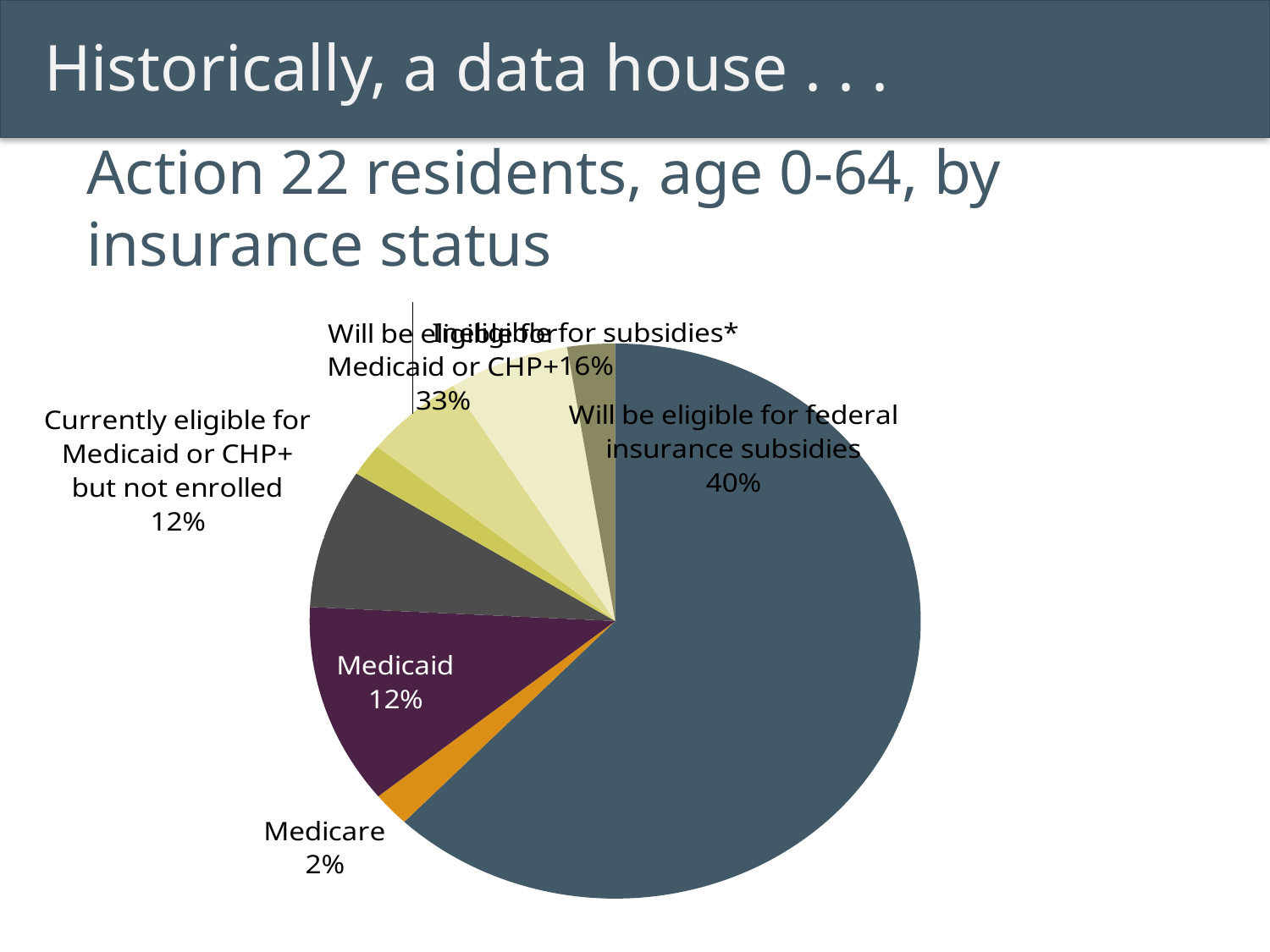
What share of residents are currently eligible for Medicaid or CHP+ but not enrolled? 12% Which category has the largest slice of the pie? Will be eligible for federal insurance subsidies What share of residents will be eligible for federal insurance subsidies? 40% What kind of chart is shown on the slide? pie chart What share of residents are on Medicare? 2% What share of residents are on Medicaid? 12% How many percentage points larger is the Medicaid slice than the Medicare slice? 10 Which is larger, the Medicaid slice or the Medicare slice? Medicaid What is the title of the chart? Action 22 residents, age 0-64, by insurance status What colour is the 'Will be eligible for federal insurance subsidies' slice? dark teal/grey-blue How many percentage points larger is the 'Will be eligible for federal insurance subsidies' slice than the Medicaid slice? 28